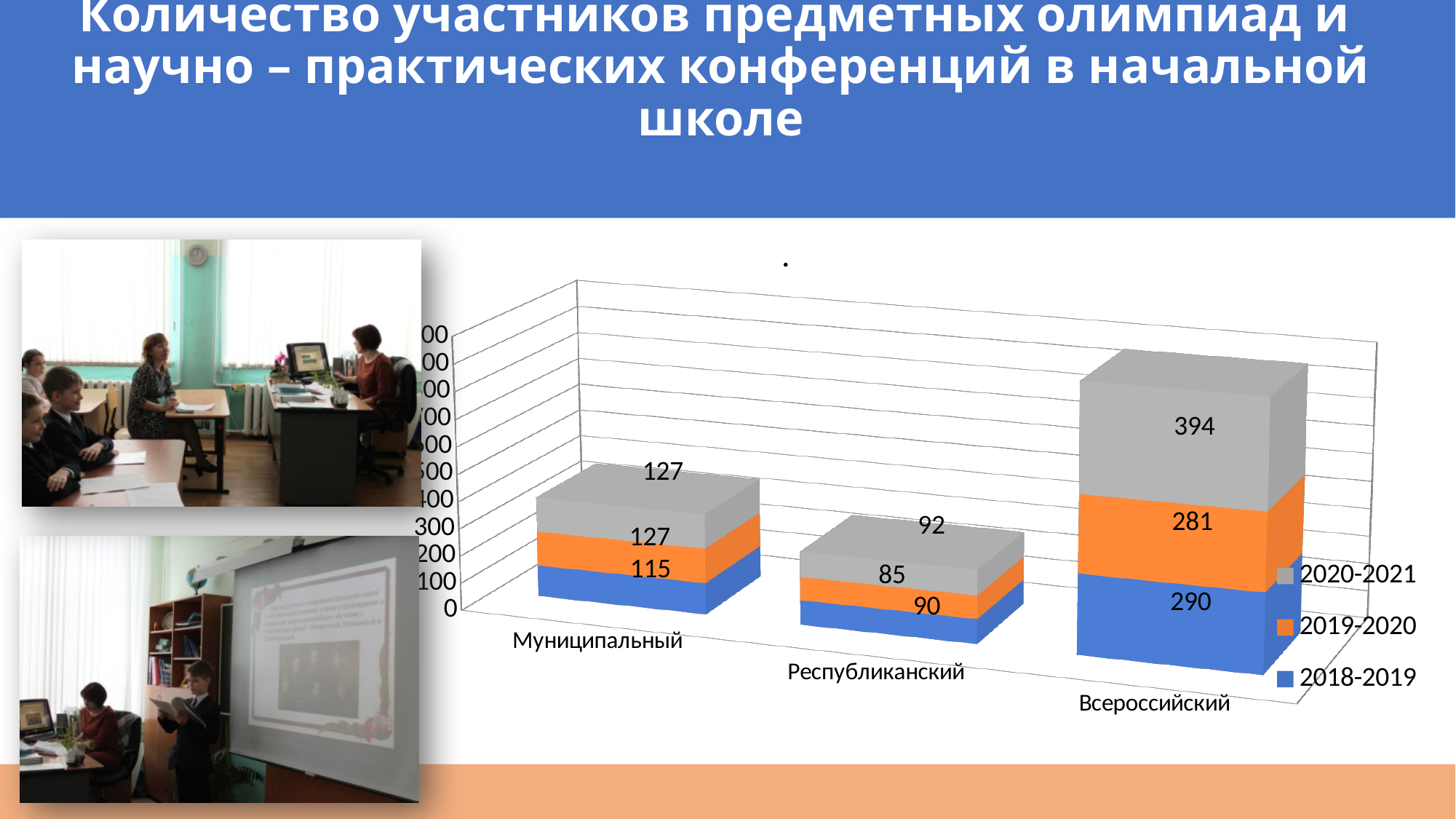
How many series does the chart legend list? 3 How many categories are shown on the x axis of the chart? 3 Which is larger: the 2018-2019 value for Муниципальный or the 2018-2019 value for Республиканский? Муниципальный What is the value for Всероссийский in the 2020-2021 series? 394 What is the value for Муниципальный in the 2019-2020 series? 127 What kind of chart is shown on the slide? Stacked bar chart What is the value for Республиканский in the 2018-2019 series? 90 Which category has the highest value in the 2018-2019 series? Всероссийский Which series is shown in orange in the chart legend? 2019-2020 Which category has the lowest value in the 2020-2021 series? Республиканский What is the total of the stacked bar for Республиканский? 267 What is the difference between the 2020-2021 and 2019-2020 values for Всероссийский? 113